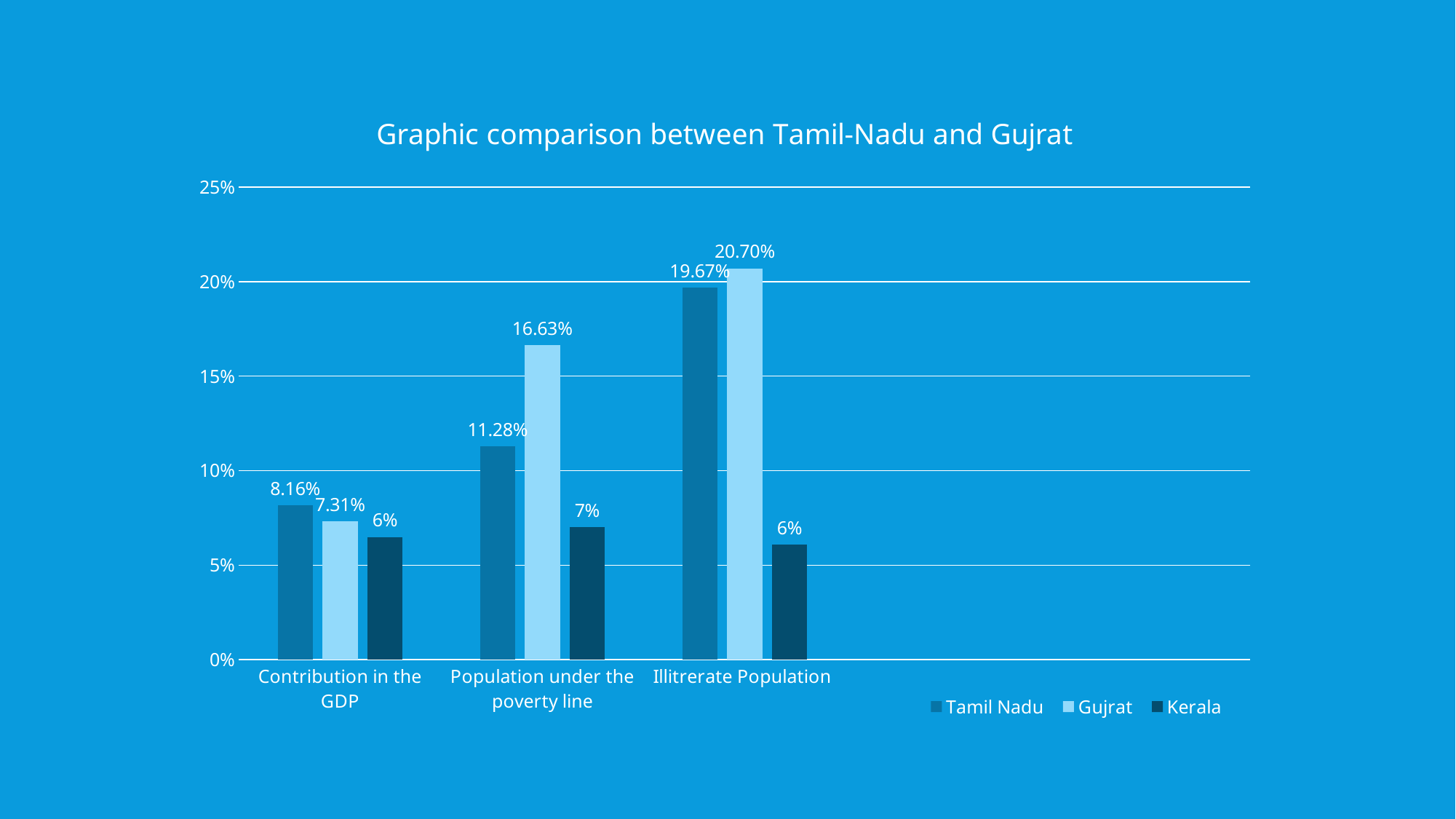
How many categories are shown on the x axis? 3 What is the value for Gujrat in Illitrerate Population? 20.70% Which category has the lowest value for Gujrat? Contribution in the GDP Which is larger in Contribution in the GDP: Tamil Nadu or Gujrat? Tamil Nadu What is the value for Gujrat in Population under the poverty line? 16.63% What is the difference between Gujrat and Tamil Nadu in Population under the poverty line? 5.35% What is the value for Tamil Nadu in Contribution in the GDP? 8.16% Which category has the highest value for Tamil Nadu? Illitrerate Population What is the title of the chart? Graphic comparison between Tamil-Nadu and Gujrat What kind of chart is shown on the slide? Bar chart What is the value for Kerala in Illitrerate Population? 6% How many series does the legend list? 3